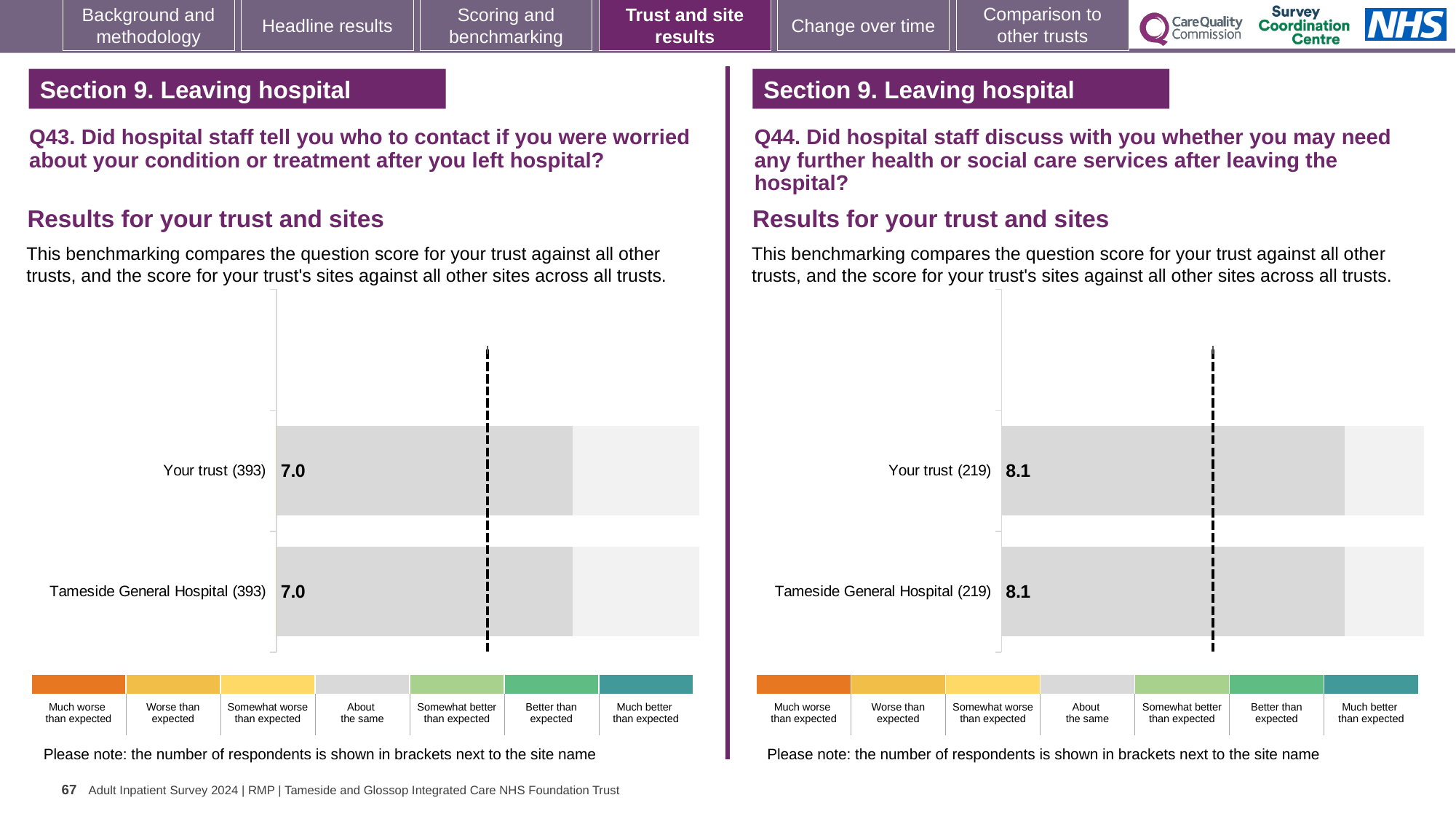
What kind of chart is the Q43 chart on the left? Bar chart In the Q43 chart on the left, what is the difference between the score for Your trust and the score for Tameside General Hospital? 0.0 In the Q44 chart on the right, how many respondents are shown in brackets for Tameside General Hospital? 219 In the Q44 chart on the right, how many bars are plotted? 2 In the Q44 chart on the right, what is the score for Tameside General Hospital? 8.1 In the Q43 chart on the left, what is the score for Your trust? 7.0 In the Q43 chart on the left, what is the score for Tameside General Hospital? 7.0 In the Q43 chart on the left, which category in the colour key is shown in grey? About the same In the Q43 chart on the left, how many respondents are shown in brackets for Your trust? 393 In the Q44 chart on the right, what is the score for Your trust? 8.1 Which chart shows a higher score for Your trust, the Q43 chart on the left or the Q44 chart on the right? The Q44 chart on the right In the Q44 chart on the right, how many categories does the colour key below the chart list? 7